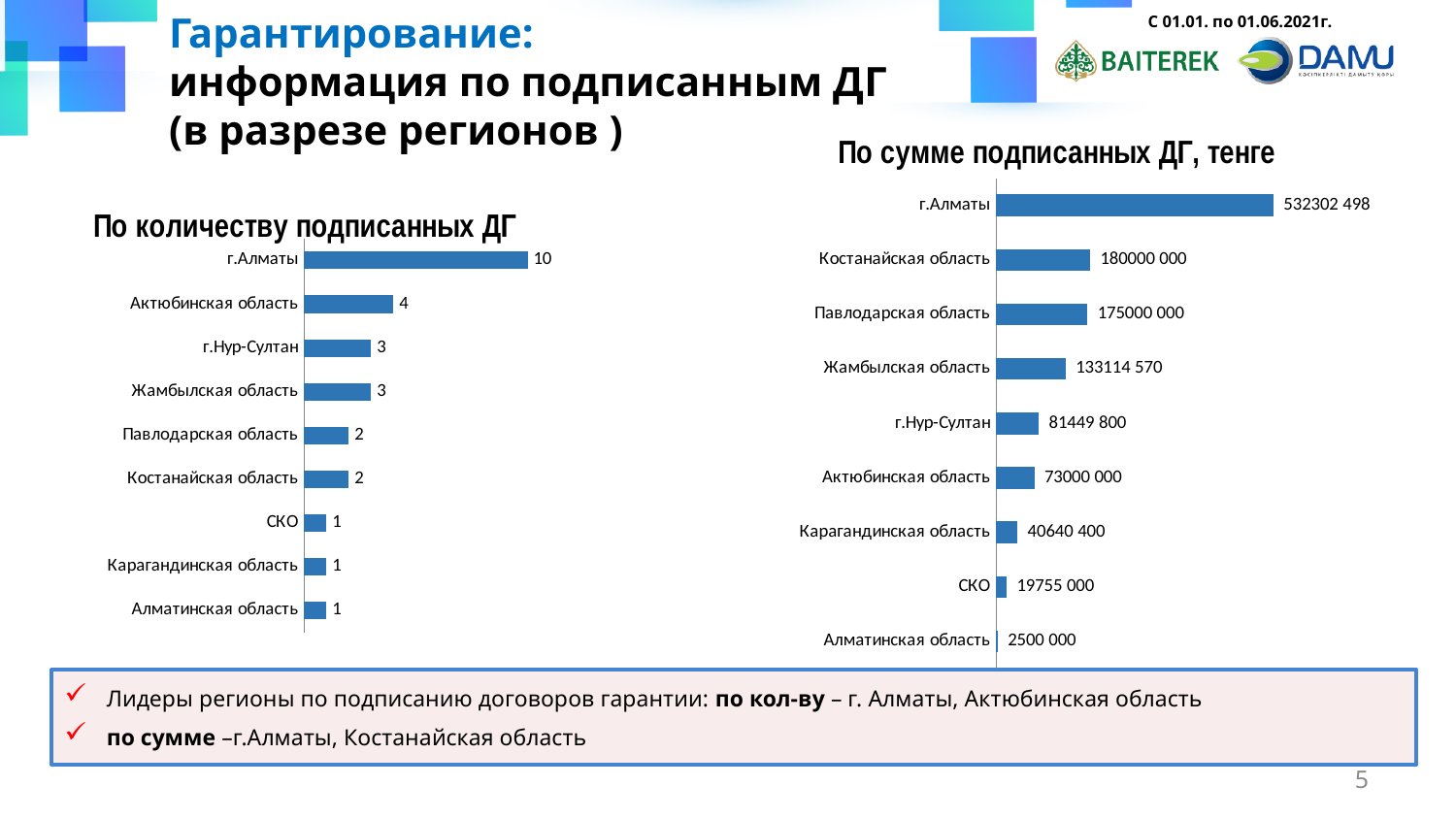
What type of chart is 'По сумме подписанных ДГ, тенге'? bar chart In the chart 'По сумме подписанных ДГ, тенге', how many categories are shown? 9 In the chart 'По сумме подписанных ДГ, тенге', what is the value for СКО? 19755 000 In the chart 'По сумме подписанных ДГ, тенге', what is the value for Жамбылская область? 133114 570 In the chart 'По сумме подписанных ДГ, тенге', what is the value for Костанайская область? 180000 000 In the chart 'По количеству подписанных ДГ', what is the difference between г.Алматы and Актюбинская область? 6 In the chart 'По количеству подписанных ДГ', what is the value for Актюбинская область? 4 In the chart 'По количеству подписанных ДГ', how many categories are shown? 9 In the chart 'По сумме подписанных ДГ, тенге', which is larger: Павлодарская область or г.Нур-Султан? Павлодарская область In the chart 'По количеству подписанных ДГ', what is the value for г.Алматы? 10 In the chart 'По количеству подписанных ДГ', which category has the highest value? г.Алматы In the chart 'По сумме подписанных ДГ, тенге', which category has the lowest value? Алматинская область